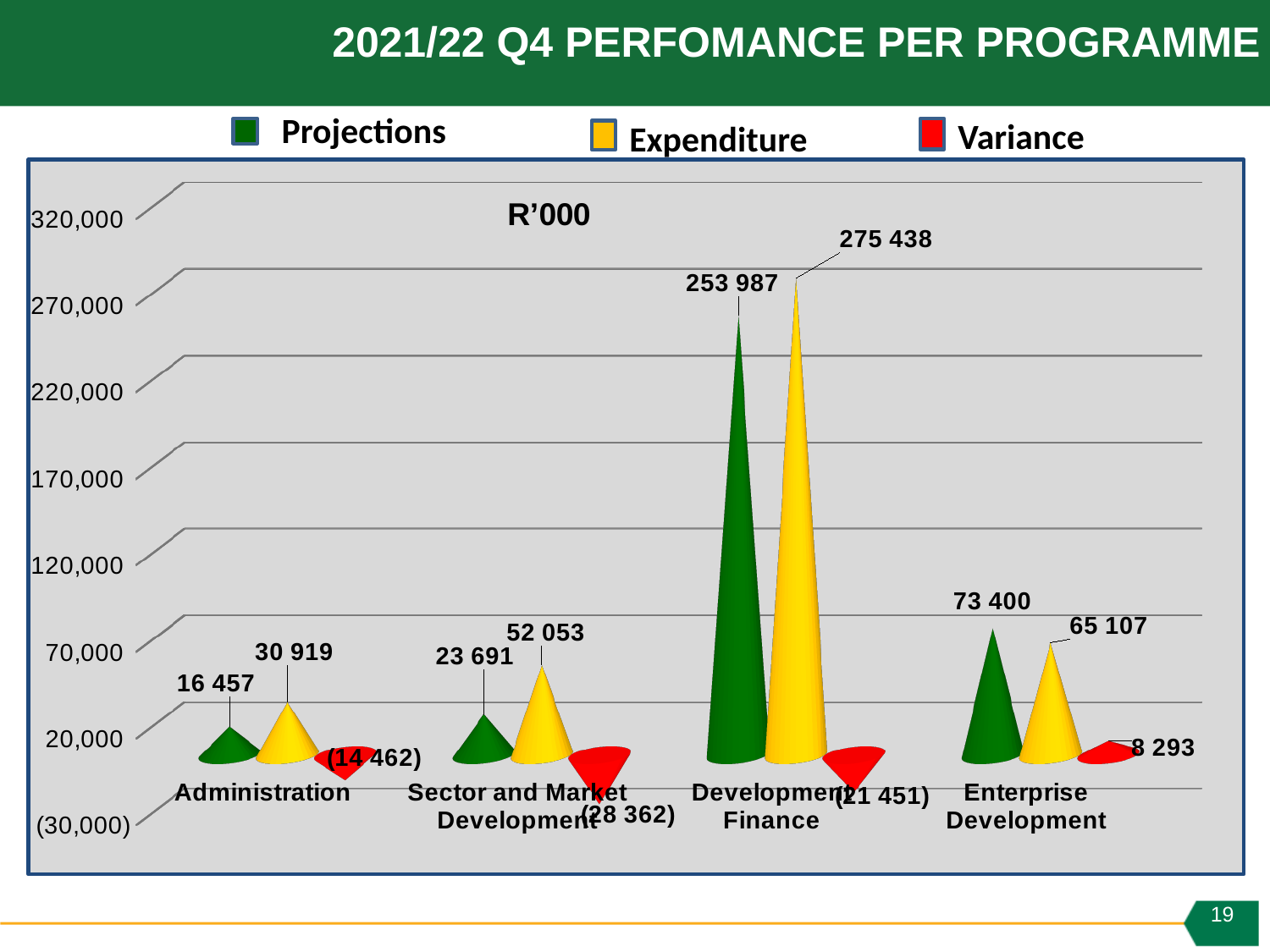
Which programme has the lowest Projections value? Administration What is the Projections value for Development Finance? 253 987 What is the Expenditure value for Enterprise Development? 65 107 What is the Expenditure value for Administration? 30 919 Which programme is the only one with a positive Variance? Enterprise Development How many series does the legend list? 3 What kind of chart is shown on the slide? Bar chart How many programmes are shown on the x axis? 4 What is the difference between Expenditure and Projections for Development Finance? 21 451 Which programme has the highest Expenditure? Development Finance What is the Variance value for Sector and Market Development? (28 362) Which is larger for Enterprise Development, Projections or Expenditure? Projections